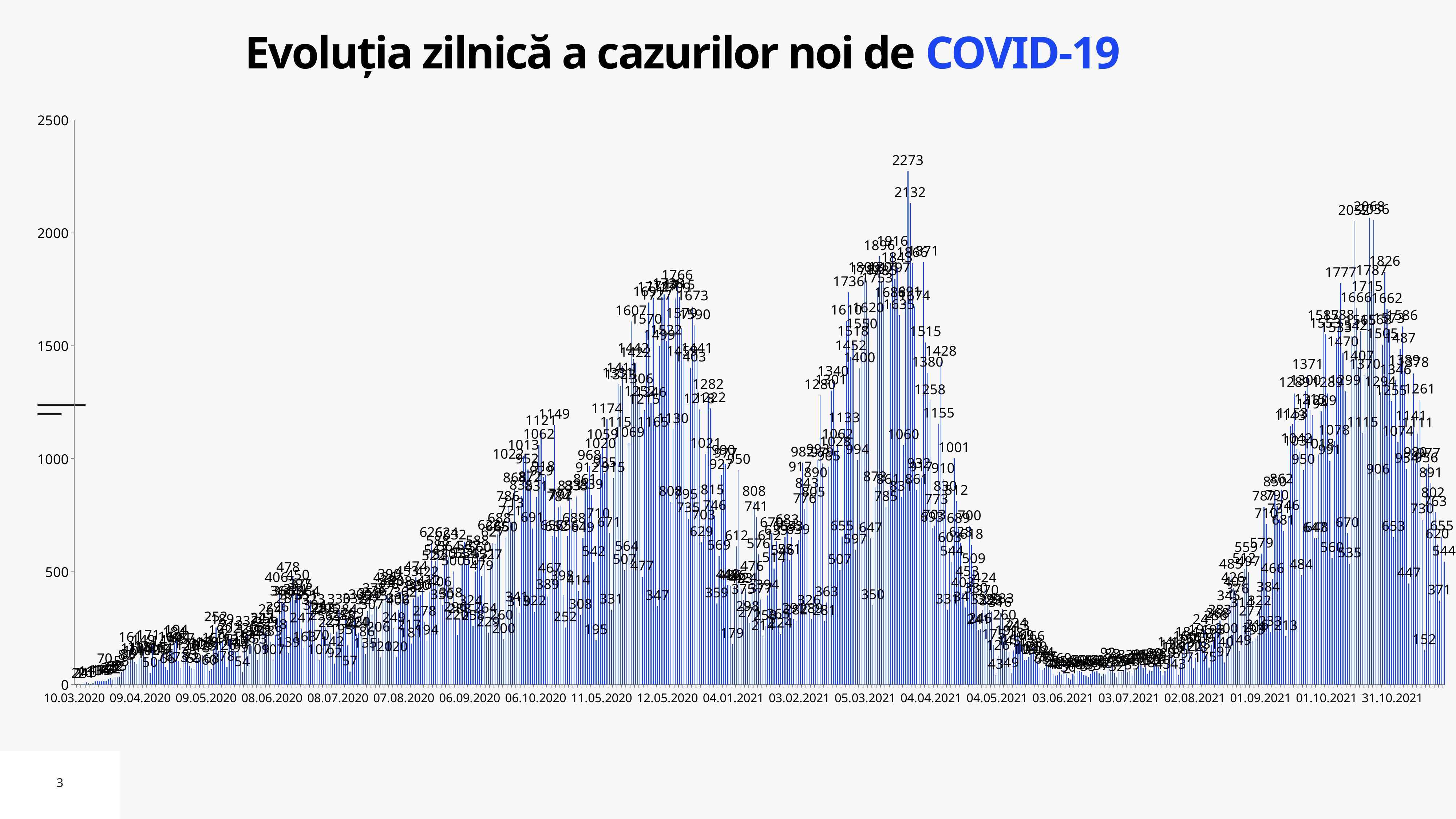
What is the highest value labeled in the peak around 12.05.2020? 1766 Is the highest value on the chart greater or less than 2000? greater Are the values around 03.07.2021 greater or less than 500? less Do the values rise or fall between 04.04.2021 and 03.06.2021? fall What kind of chart is shown on the slide? bar chart What is the highest daily value labeled on the chart? 2273 Which peak is higher: the one around 04.04.2021 or the one around 12.05.2020? 04.04.2021 Do the values rise or fall between 01.09.2021 and 01.10.2021? rise What is the title of the chart? Evoluția zilnică a cazurilor noi de COVID-19 What is the highest value shown on the y axis? 2500 What is the first date shown on the x axis? 10.03.2020 Is the peak around 12.05.2020 greater or less than 1500? greater